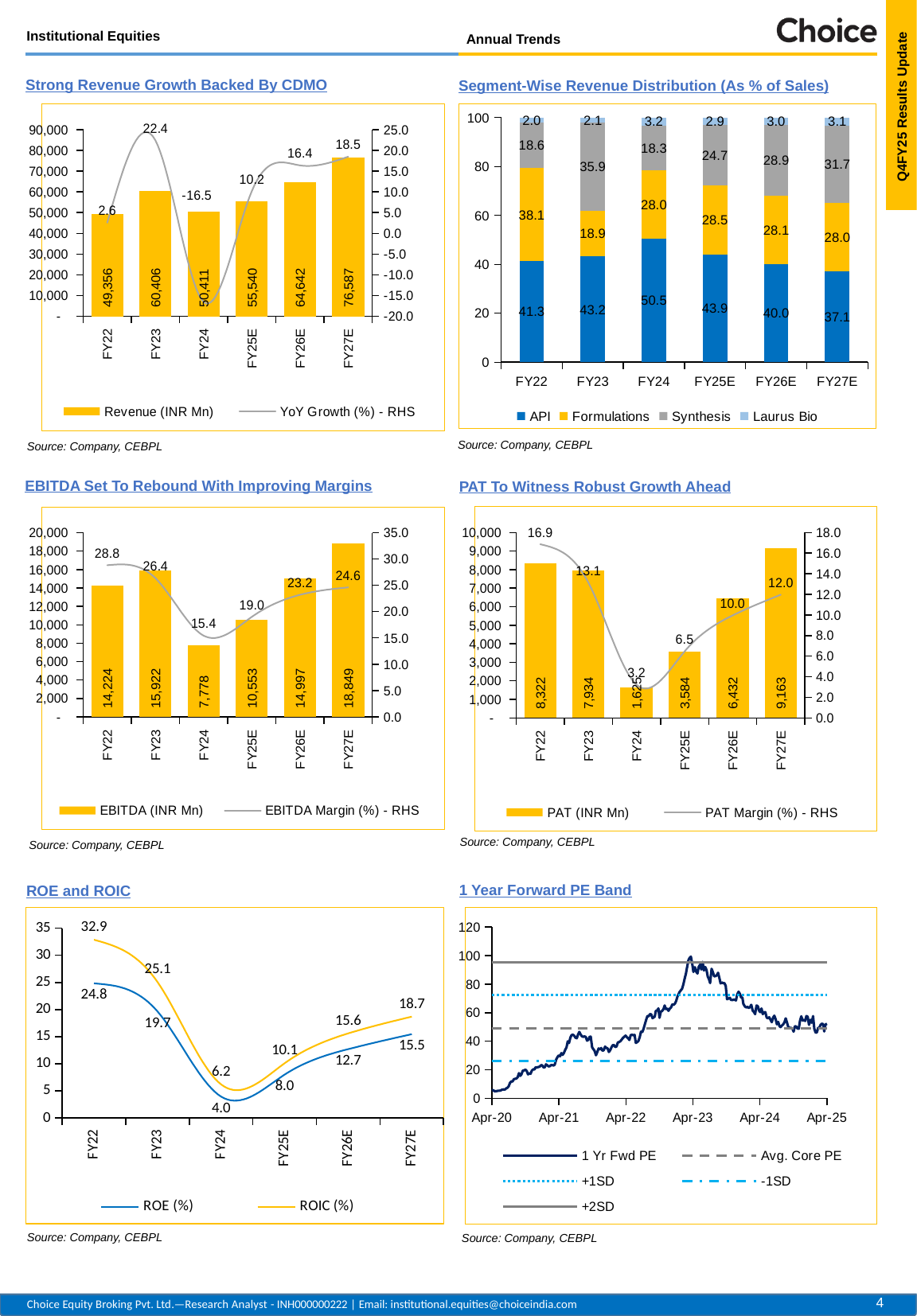
In the 'Segment-Wise Revenue Distribution (As % of Sales)' chart, what is the Synthesis share for FY23? 35.9 In the 'Strong Revenue Growth Backed By CDMO' chart, which year has the lowest YoY Growth (%)? FY24 What kind of chart is the '1 Year Forward PE Band' chart? Line chart In the 'Segment-Wise Revenue Distribution (As % of Sales)' chart, how many series does the legend list? 4 In the 'PAT To Witness Robust Growth Ahead' chart, which year has the lowest PAT (INR Mn)? FY24 In the 'ROE and ROIC' chart, what is the ROIC (%) for FY27E? 18.7 In the 'EBITDA Set To Rebound With Improving Margins' chart, what is the EBITDA Margin (%) for FY22? 28.8 In the 'Strong Revenue Growth Backed By CDMO' chart, what is the Revenue (INR Mn) for FY24? 50,411 In the 'PAT To Witness Robust Growth Ahead' chart, is the PAT (INR Mn) for FY27E larger than for FY22? Yes, FY27E (9,163) In the 'EBITDA Set To Rebound With Improving Margins' chart, what is the EBITDA (INR Mn) for FY25E? 10,553 In the 'Segment-Wise Revenue Distribution (As % of Sales)' chart, which year has the highest API share? FY24 In the 'Strong Revenue Growth Backed By CDMO' chart, what is the difference in Revenue (INR Mn) between FY27E and FY26E? 11,945